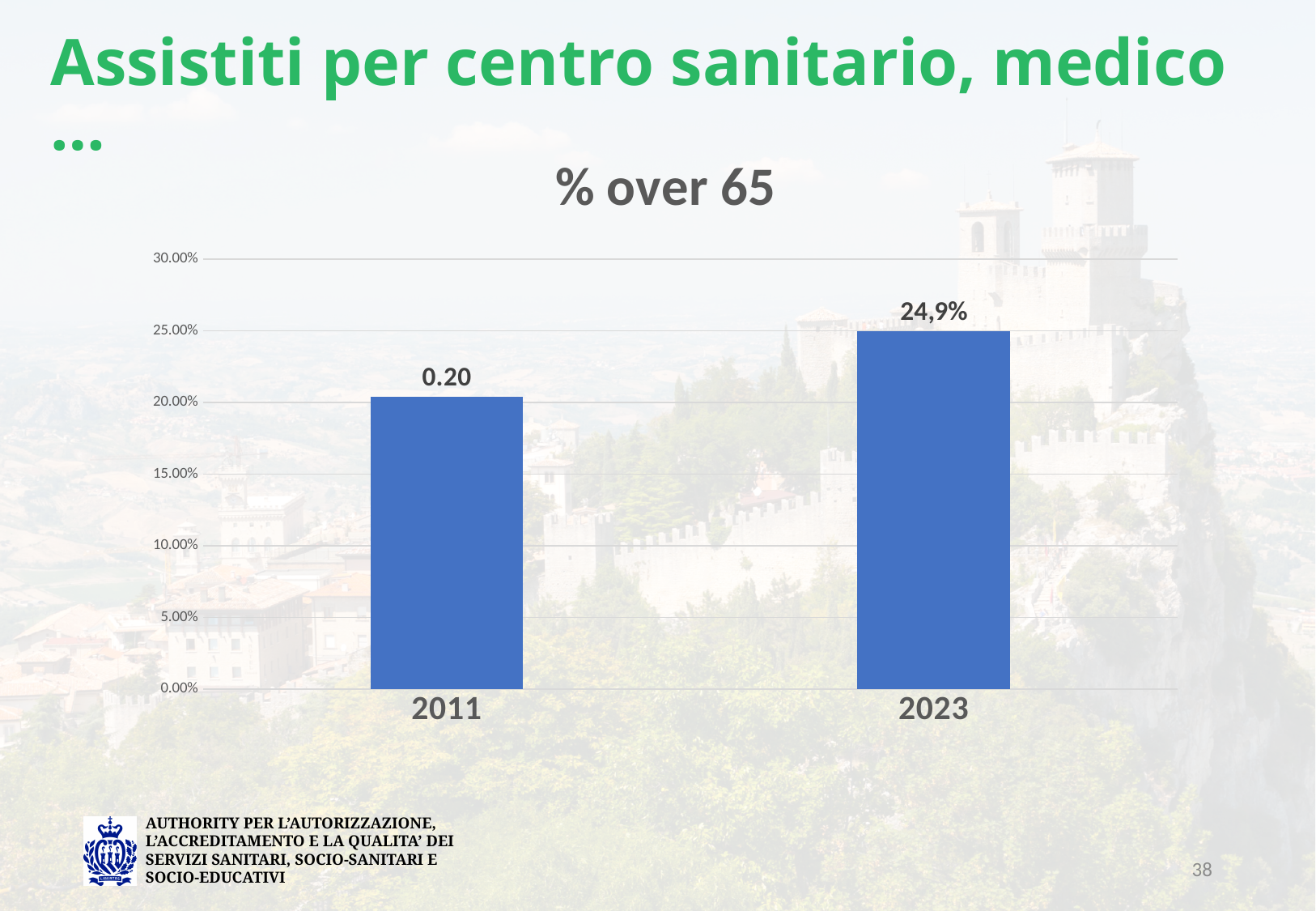
How many bars are shown in the chart? 2 What type of chart is shown on the slide? Bar chart What is the title of the chart? % over 65 What is the data label shown on the 2011 bar? 0.20 Is the value for 2023 greater or less than 20.00%? greater Do the values rise or fall from 2011 to 2023? Rise Which year has the lower bar? 2011 Is the value for 2023 greater or less than 30.00%? less Is the bar for 2023 taller than the bar for 2011? Yes Which year has the higher bar? 2023 What is the data label shown on the 2023 bar? 24,9% Is the value for 2011 greater or less than 25.00%? less